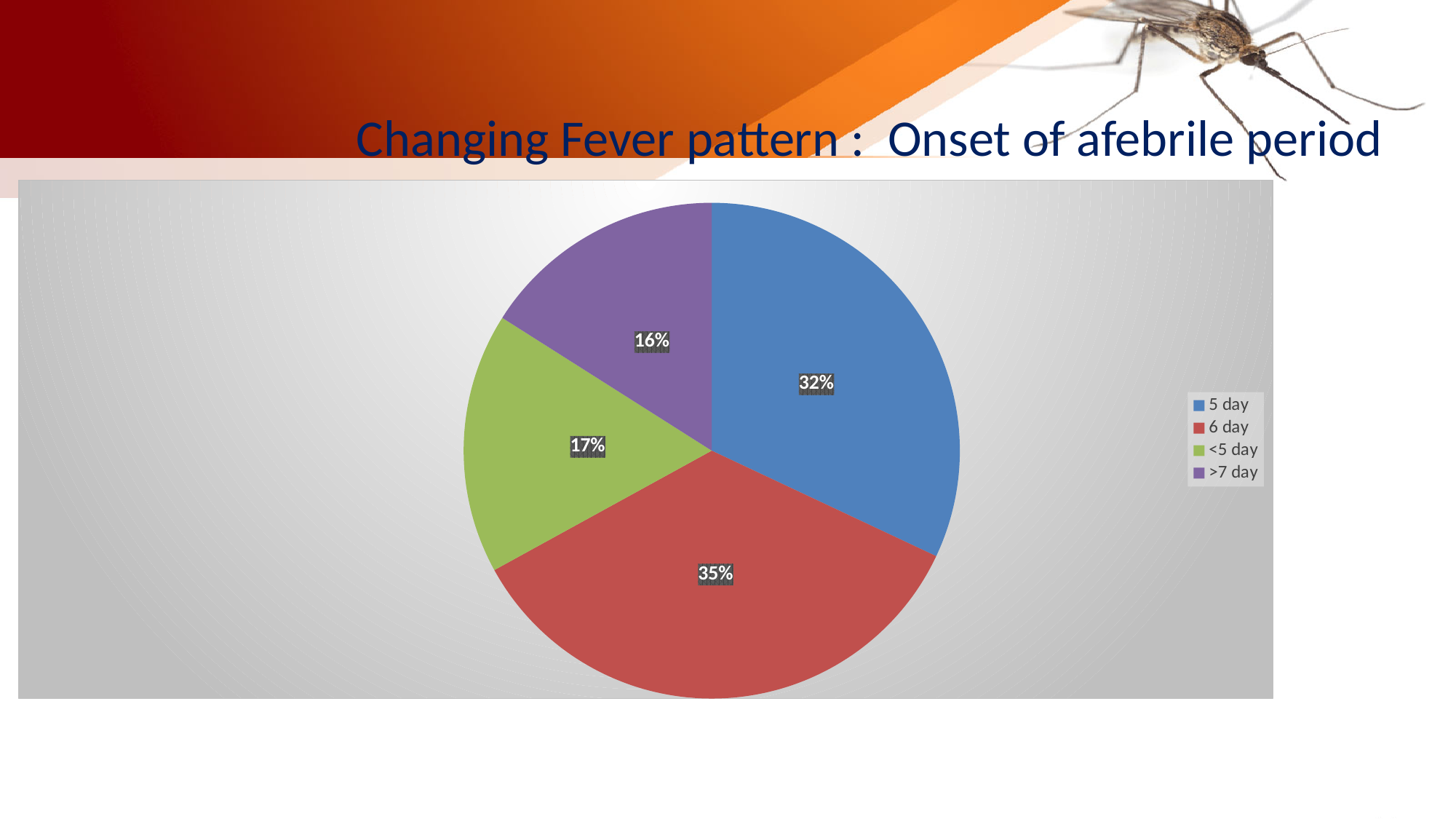
Which slice is larger, "5 day" or "<5 day"? 5 day Which category has the smallest slice of the pie? >7 day What colour is the "<5 day" slice in the pie chart? green What share of the pie does the ">7 day" slice represent? 16% What share of the pie does the "5 day" slice represent? 32% What is the difference in percentage points between the "6 day" and "5 day" slices? 3 What share of the pie does the "6 day" slice represent? 35% How many slices does the pie chart have? 4 Which category has the largest slice of the pie? 6 day What is the title of the slide containing the pie chart? Changing Fever pattern : Onset of afebrile period What kind of chart is shown on the slide? pie chart